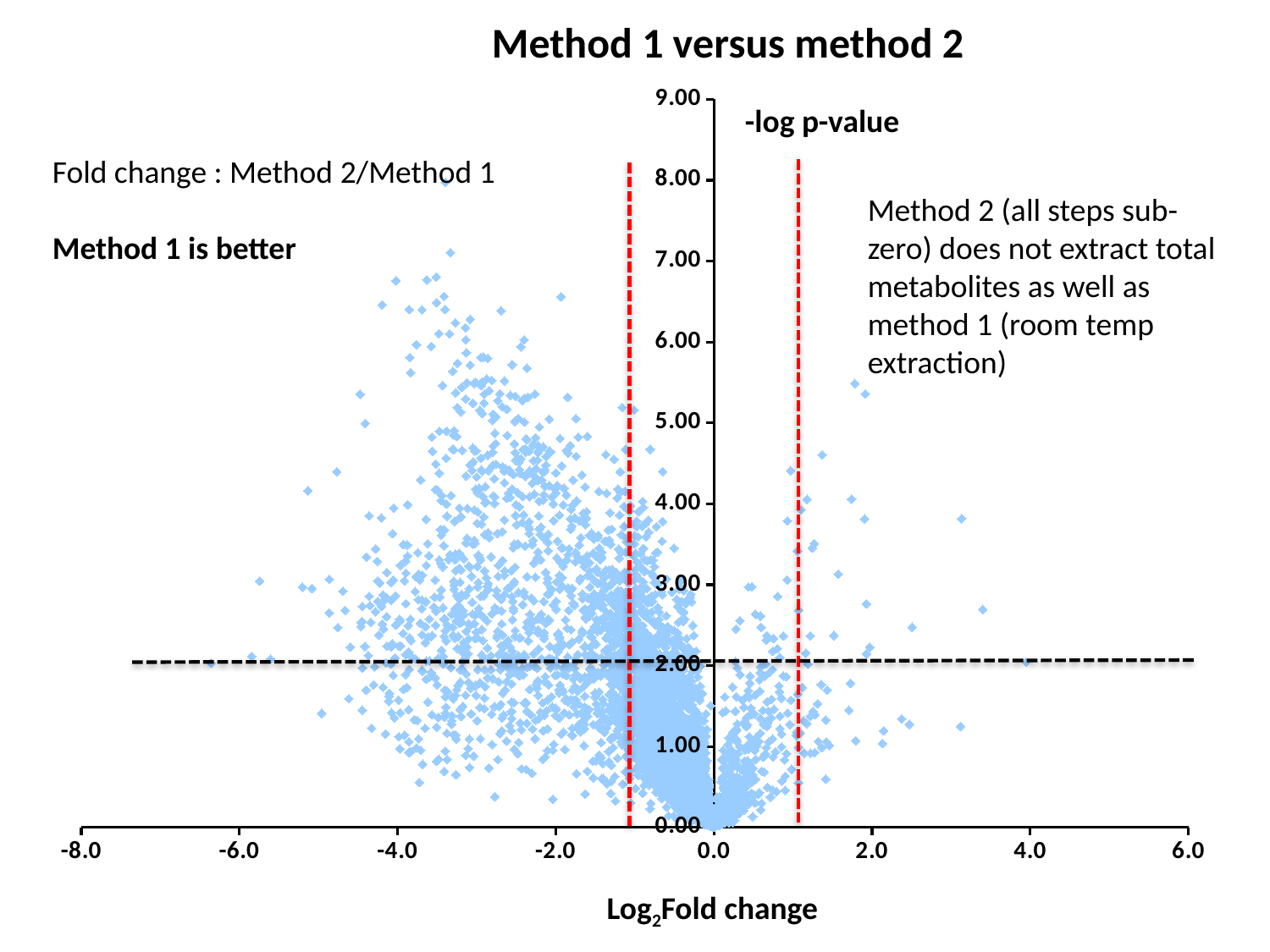
Is the -log p-value of the highest plotted point greater or less than 7.00? greater What is the highest value shown on the y axis? 9.00 Is the left-hand red dashed vertical line at a Log2Fold change greater or less than -2.0? greater What kind of chart is shown on the slide? scatter chart Is the right-hand red dashed vertical line at a Log2Fold change greater or less than 2.0? less What is the label of the x axis? Log2Fold change Are there more plotted points to the left or to the right of 0.0 on the x axis? left What is the title of the chart? Method 1 versus method 2 What is the lowest value shown on the x axis? -8.0 What is the highest value shown on the x axis? 6.0